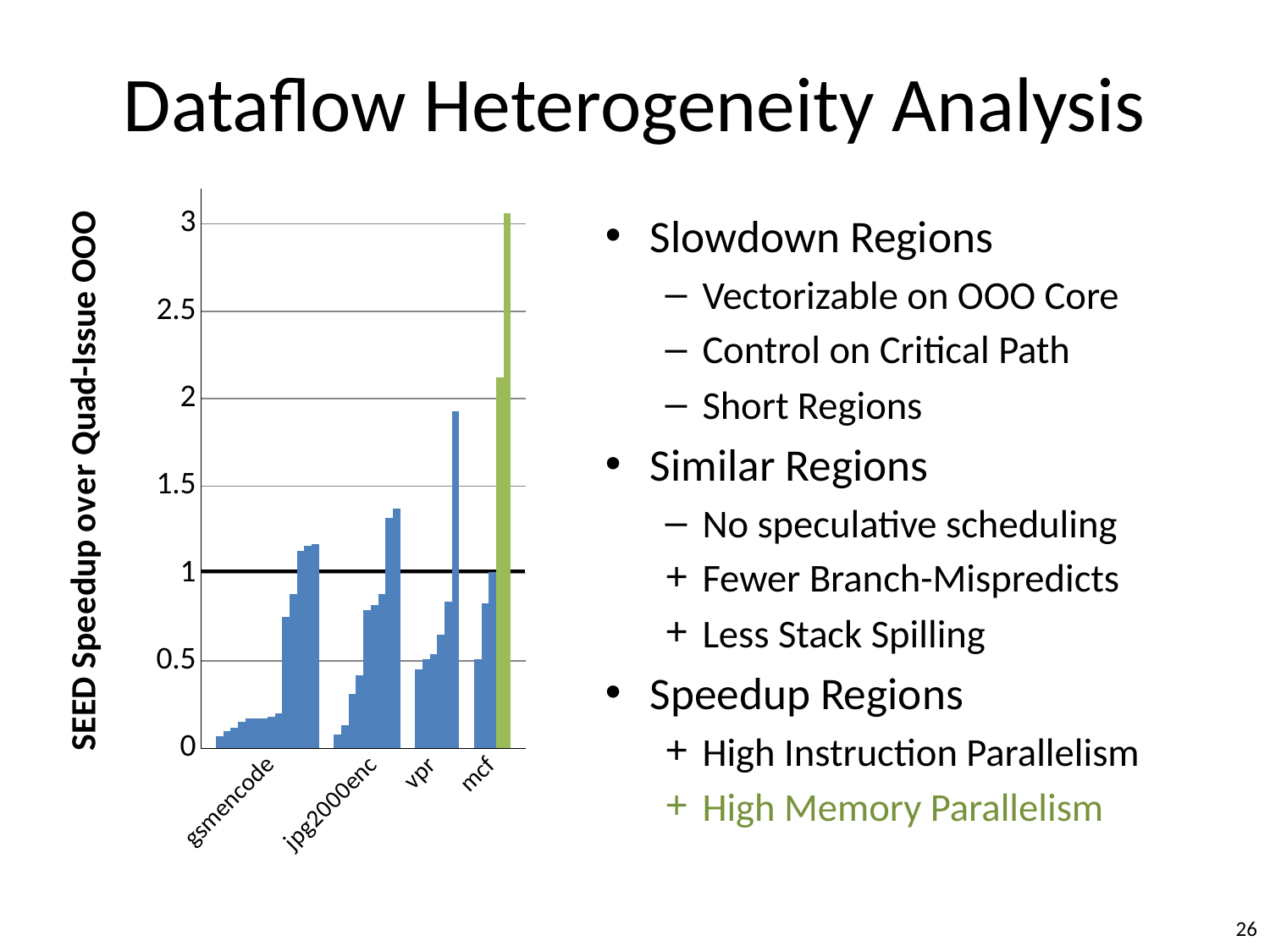
Is the tallest bar for vpr greater or less than 2? less What is the highest tick value shown on the y axis of the chart? 3 Which benchmark category contains the tallest bar in the chart? mcf Is the tallest bar for mcf greater or less than 2.5? greater What is the title of the y axis of the chart? SEED Speedup over Quad-Issue OOO Is the tallest bar for gsmencode greater or less than 1.5? less What kind of chart is shown on the slide? bar chart How many benchmark categories are labeled on the x axis of the chart? 4 Which benchmark category has its bars drawn in green rather than blue? mcf At what y-axis value is the bold horizontal reference line drawn across the chart? 1